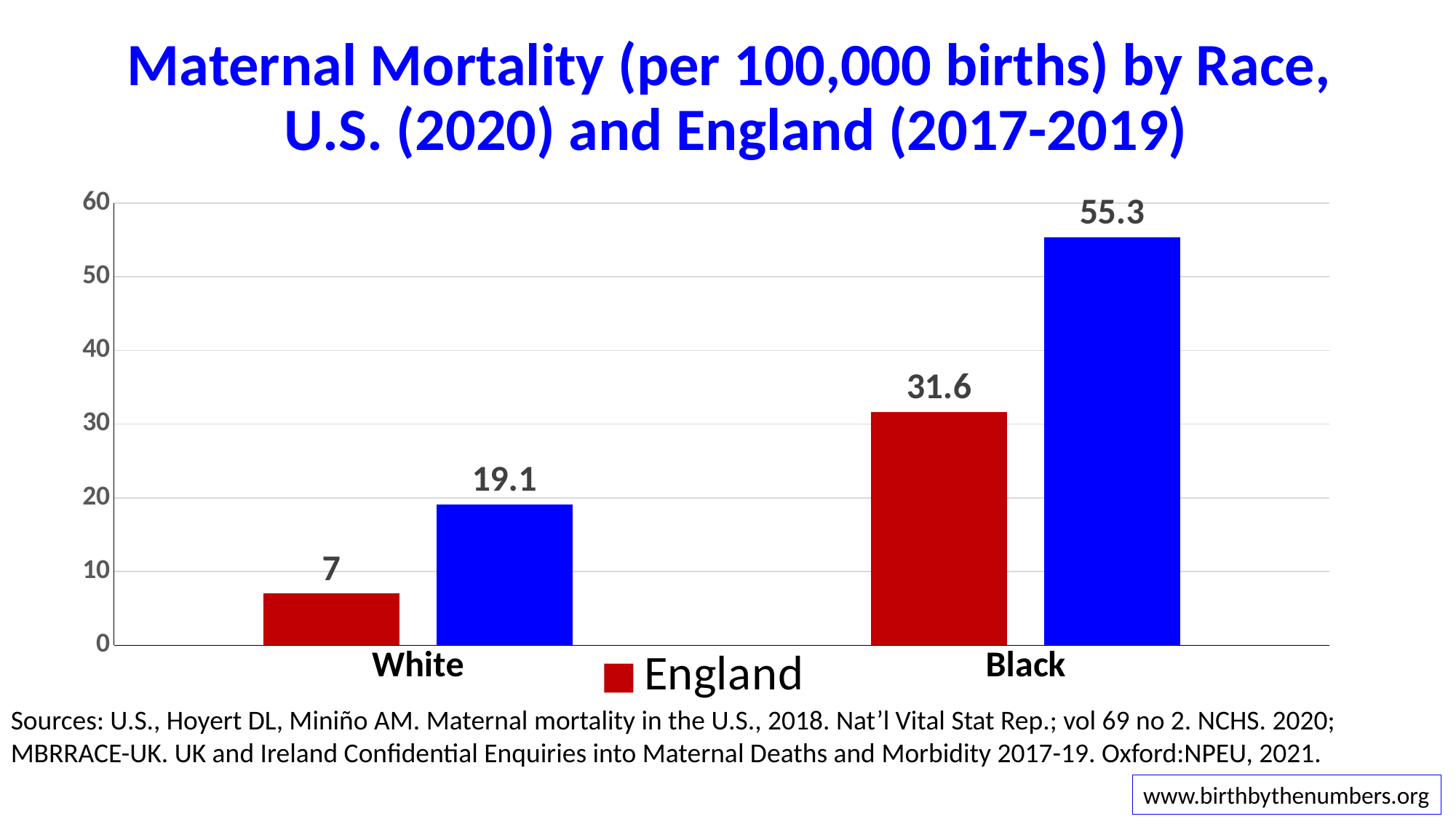
What value is shown on the blue bar for the Black category? 55.3 What is the maternal mortality value for England in the White category? 7 In the Black category, how much higher is the blue bar than the England bar? 23.7 What kind of chart is shown on the slide? Bar chart What is the maternal mortality value for England in the Black category? 31.6 What is the difference between the England values for Black and White? 24.6 What value is shown on the blue bar for the White category? 19.1 Which is larger: the England value for Black or the blue bar value for White? The England value for Black (31.6) How many race categories are shown on the x axis? 2 Which bar on the chart is the shortest? The England bar for White (7) What colour are the England bars? Red Which bar on the chart is the tallest? The blue bar for Black (55.3)